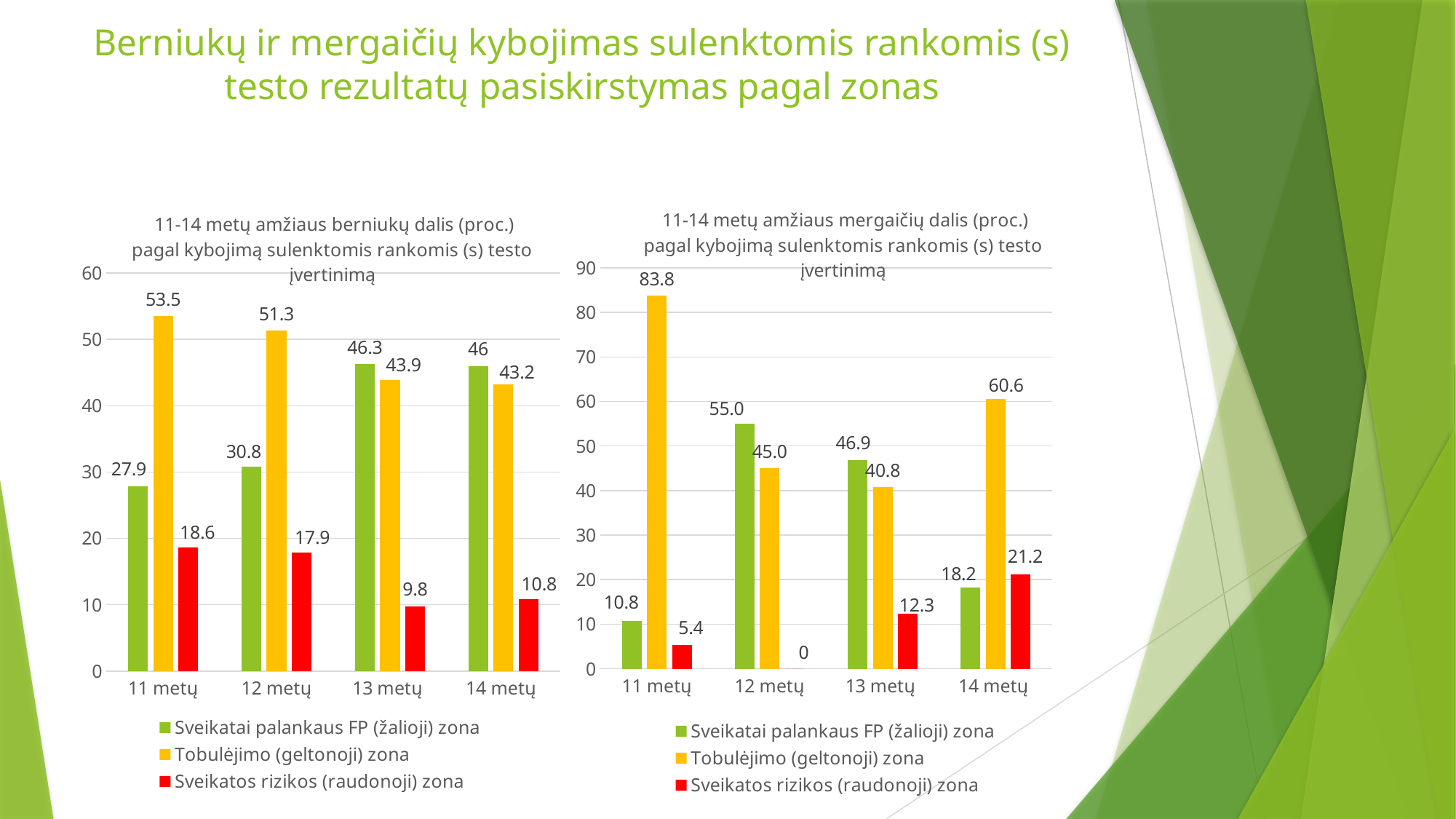
In the right chart (girls), what is the difference between the Sveikatai palankaus FP (žalioji) zona and Tobulėjimo (geltonoji) zona values at 12 metų? 10.0 In the left chart (boys), which age group has the lowest value for Sveikatos rizikos (raudonoji) zona? 13 metų In the right chart (girls), at 14 metų, which is larger: Sveikatai palankaus FP (žalioji) zona or Sveikatos rizikos (raudonoji) zona? Sveikatos rizikos (raudonoji) zona In the right chart (girls), which age group has the highest value for Tobulėjimo (geltonoji) zona? 11 metų How many age groups are shown on the x axis of the left chart (boys)? 4 How many series does the legend of the right chart (girls) list? 3 In the left chart (boys), is the value for Sveikatai palankaus FP (žalioji) zona at 13 metų greater or less than 40? greater What kind of chart is the left chart (boys)? Bar chart In the left chart (boys), what is the difference between the Tobulėjimo (geltonoji) zona values at 11 metų and 12 metų? 2.2 In the left chart (boys), what is the value for Tobulėjimo (geltonoji) zona at 11 metų? 53.5 In the left chart (boys), does the Sveikatai palankaus FP (žalioji) zona value rise or fall from 11 metų to 13 metų? Rise In the right chart (girls), what is the value for Sveikatos rizikos (raudonoji) zona at 12 metų? 0